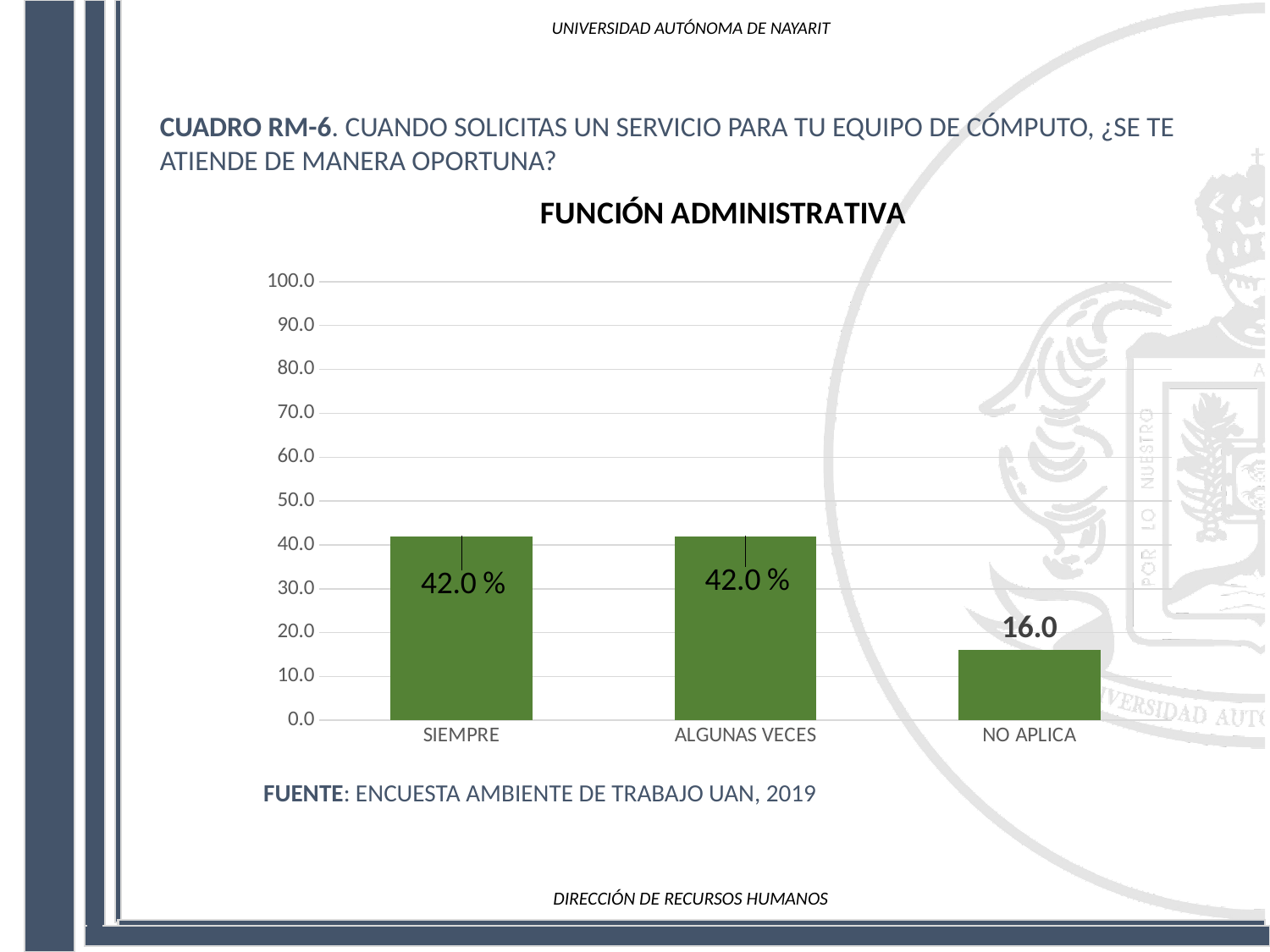
What kind of chart is shown on the slide? bar chart What is the value shown for SIEMPRE? 42.0 % What is the title of the chart? FUNCIÓN ADMINISTRATIVA Which category has the lowest value? NO APLICA How many categories are shown on the x axis? 3 What is the value shown for ALGUNAS VECES? 42.0 % By how many points does the value for ALGUNAS VECES exceed the value for NO APLICA? 26.0 Is the value for NO APLICA greater or less than 20.0? less What is the highest value marked on the vertical axis? 100.0 Is the value for SIEMPRE greater or less than 40.0? greater What is the value shown for NO APLICA? 16.0 Which is larger, the value for SIEMPRE or the value for NO APLICA? SIEMPRE